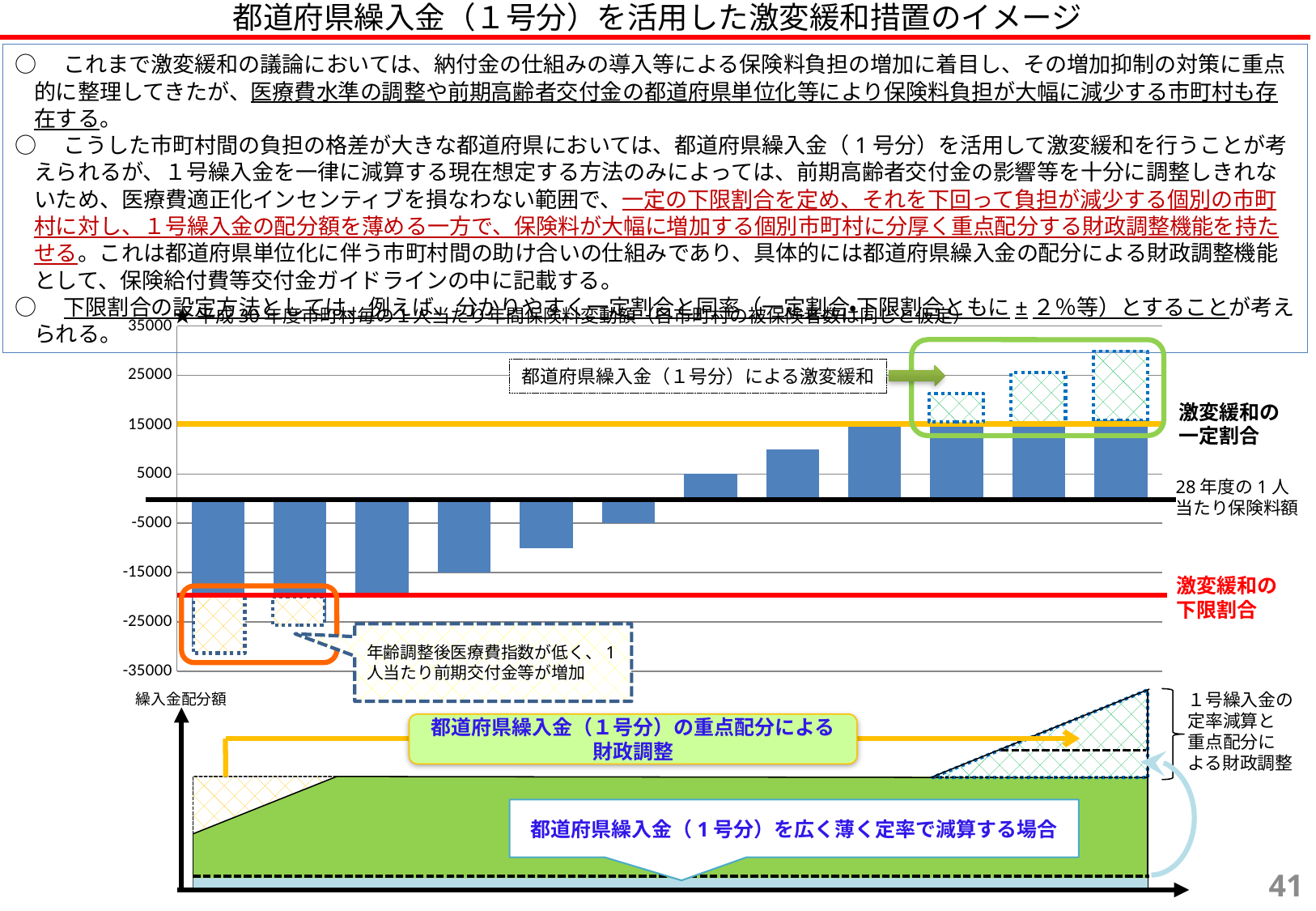
Do the bar values rise or fall from left to right in the bar chart? rise What is the lowest value shown on the vertical axis of the bar chart? -35000 What is the highest value shown on the vertical axis of the bar chart? 35000 Is the value of the rightmost blue bar in the bar chart greater or less than 5000? greater Is the value of the fifth bar from the left in the bar chart greater or less than -15000? greater Is the value of the eighth bar from the left in the bar chart greater or less than 15000? less What kind of chart is shown in the upper part of the slide? bar chart How many bars in the bar chart have negative values? 6 Which bar in the bar chart has the lowest value, the leftmost bar or the sixth bar from the left? the leftmost bar How many blue bars are plotted in the bar chart? 12